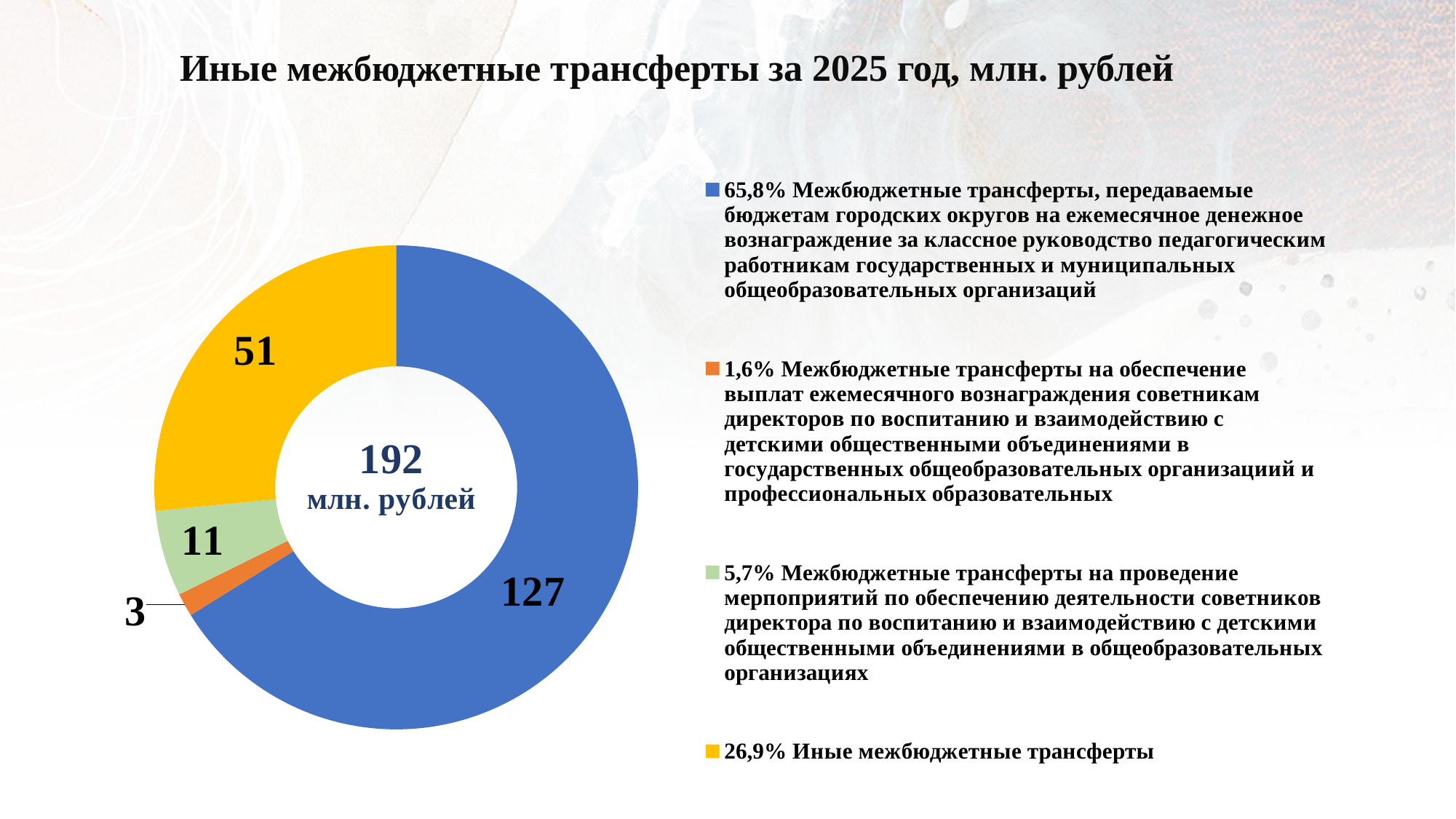
Which is larger: the green slice (11) or the orange slice (3)? The green slice (11) What is the value for the blue slice, "Межбюджетные трансферты, передаваемые бюджетам городских округов на ежемесячное денежное вознаграждение за классное руководство"? 127 What is the value for "Иные межбюджетные трансферты" (the yellow slice)? 51 What total is shown in the centre of the donut chart? 192 млн. рублей What is the difference between the blue slice (127) and the yellow slice (51)? 76 Which category has the smallest value? Межбюджетные трансферты на обеспечение выплат ежемесячного вознаграждения советникам директоров по воспитанию (3) What share of the total does "Иные межбюджетные трансферты" represent according to the legend? 26,9% What is the value for the orange slice, "Межбюджетные трансферты на обеспечение выплат ежемесячного вознаграждения советникам директоров по воспитанию"? 3 Which category has the largest value? Межбюджетные трансферты, передаваемые бюджетам городских округов на ежемесячное денежное вознаграждение за классное руководство (127) How many slices does the chart have? 4 What is the value for the green slice, "Межбюджетные трансферты на проведение мероприятий по обеспечению деятельности советников директора по воспитанию"? 11 What type of chart is shown on the slide? Pie (donut) chart